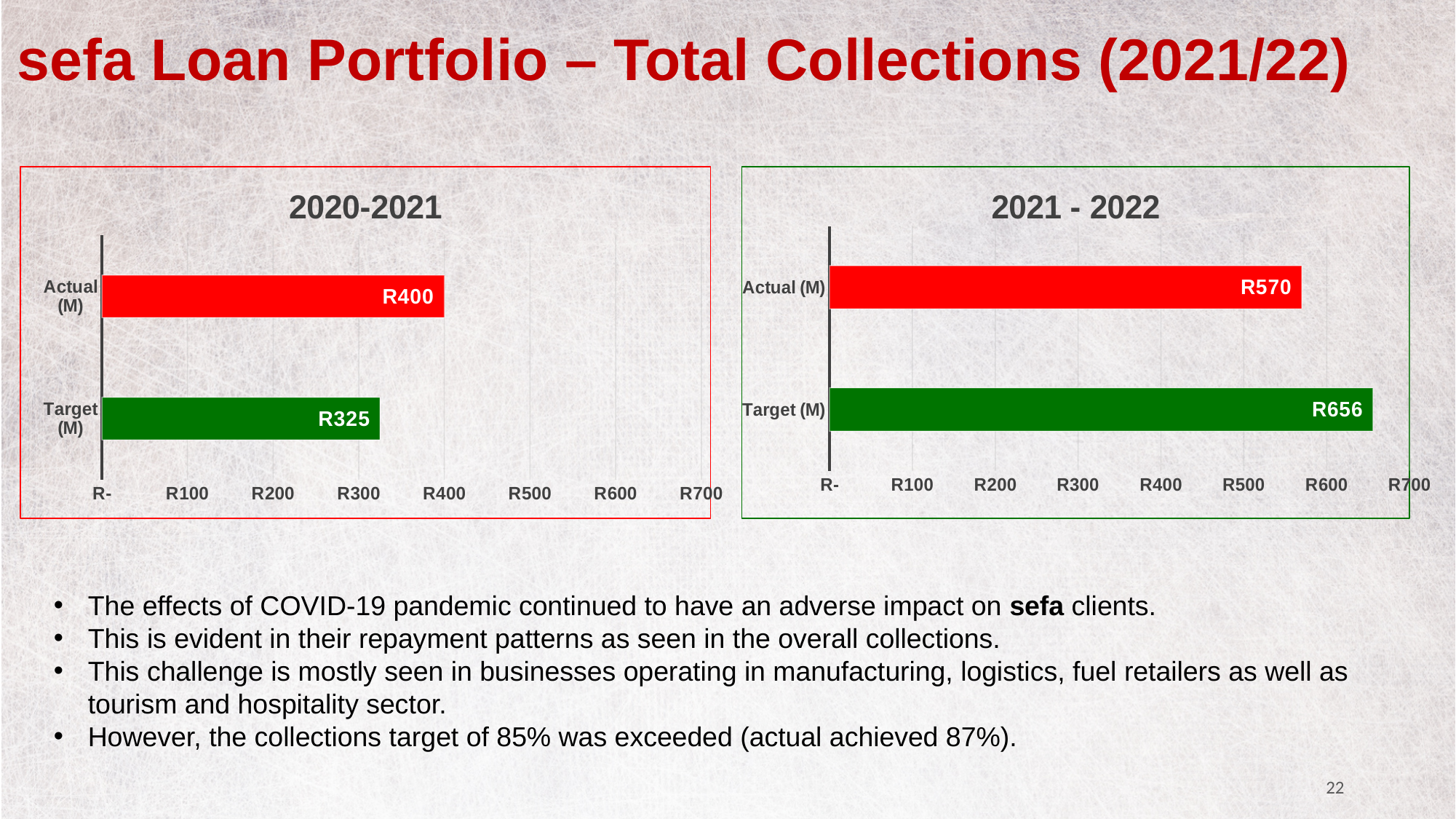
In the 2021 - 2022 chart, which category has the lower value? Actual (M) What kind of chart is the 2020-2021 chart? bar chart In the 2020-2021 chart, which category has the higher value? Actual (M) In the 2021 - 2022 chart, is the value for Actual (M) larger or smaller than the value for Target (M)? smaller In the 2021 - 2022 chart, what is the value for Actual (M)? R570 In the 2021 - 2022 chart, what is the difference between Target (M) and Actual (M)? R86 In the 2020-2021 chart, what is the value for Actual (M)? R400 In the 2021 - 2022 chart, what is the value for Target (M)? R656 In the 2020-2021 chart, what colour is the Target (M) bar? green How many categories are shown in the 2021 - 2022 chart? 2 In the 2020-2021 chart, what is the difference between Actual (M) and Target (M)? R75 In the 2020-2021 chart, what is the value for Target (M)? R325